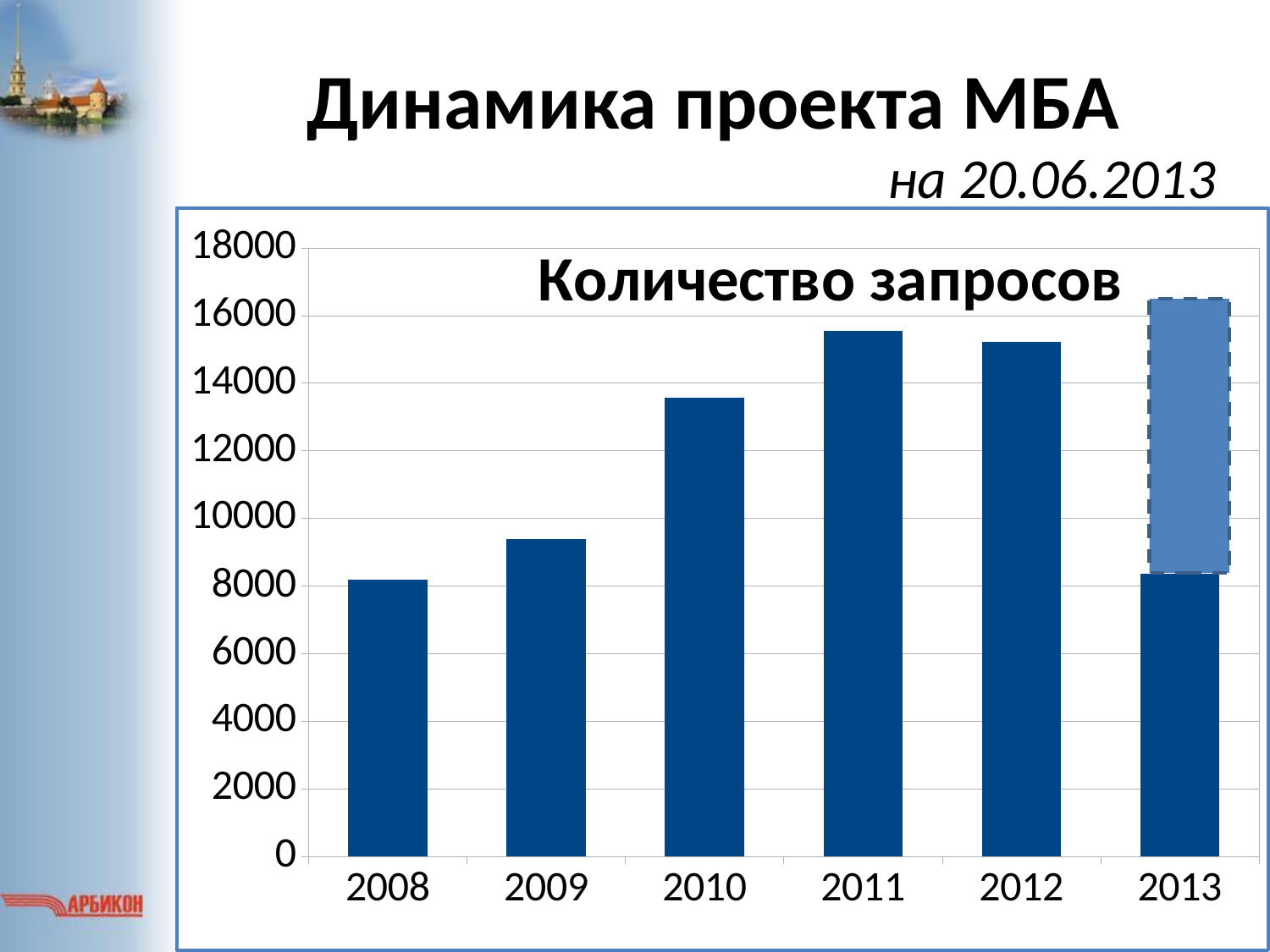
Which is larger, the value for 2011 or the value for 2008? 2011 Do the values rise or fall from 2008 to 2011? rise What is the title of the chart? Количество запросов How many years are shown on the x axis of the chart? 6 What kind of chart is shown on the slide? bar chart Which is larger, the value for 2010 or the value for 2009? 2010 Is the value for 2008 greater or less than 10000? less Is the value for 2009 greater or less than 10000? less Is the value for 2011 greater or less than 14000? greater What is the highest tick value shown on the y axis? 18000